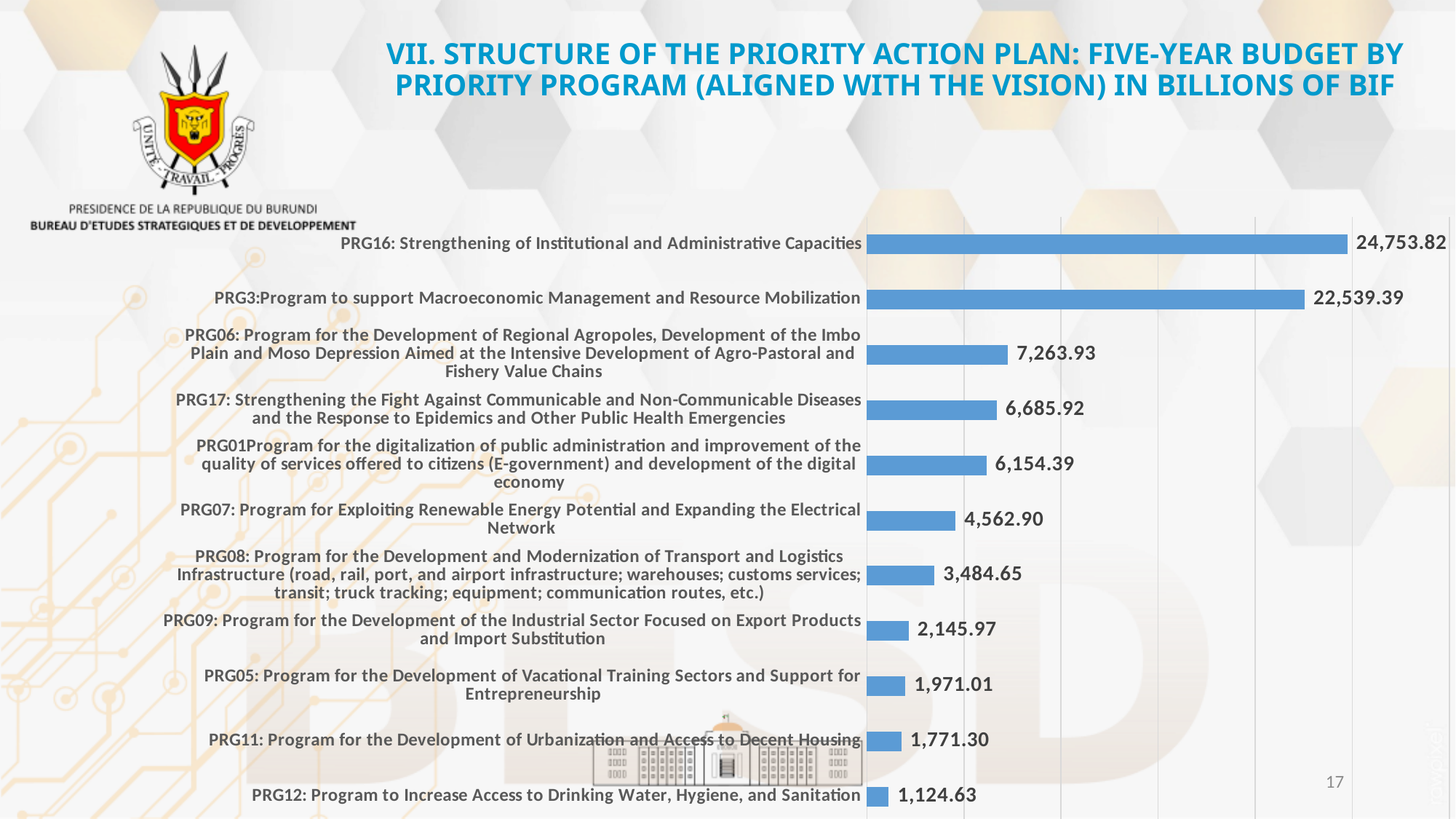
What type of chart is shown on the slide? Bar chart What value is shown for PRG07: Program for Exploiting Renewable Energy Potential and Expanding the Electrical Network? 4,562.90 Which priority program has the lowest budget in the chart? PRG12: Program to Increase Access to Drinking Water, Hygiene, and Sanitation What is the difference between the values for PRG11 and PRG12? 646.67 Which has a larger value, PRG06 or PRG01? PRG06 Which has a larger value, PRG05 or PRG09? PRG09 What value is shown for PRG17: Strengthening the Fight Against Communicable and Non-Communicable Diseases and the Response to Epidemics and Other Public Health Emergencies? 6,685.92 What is the five-year budget value shown for PRG16: Strengthening of Institutional and Administrative Capacities? 24,753.82 Which priority program has the highest budget in the chart? PRG16: Strengthening of Institutional and Administrative Capacities What value is shown for PRG12: Program to Increase Access to Drinking Water, Hygiene, and Sanitation? 1,124.63 What is the difference between the values for PRG16 and PRG3? 2,214.43 How many priority programs are plotted in the chart? 11